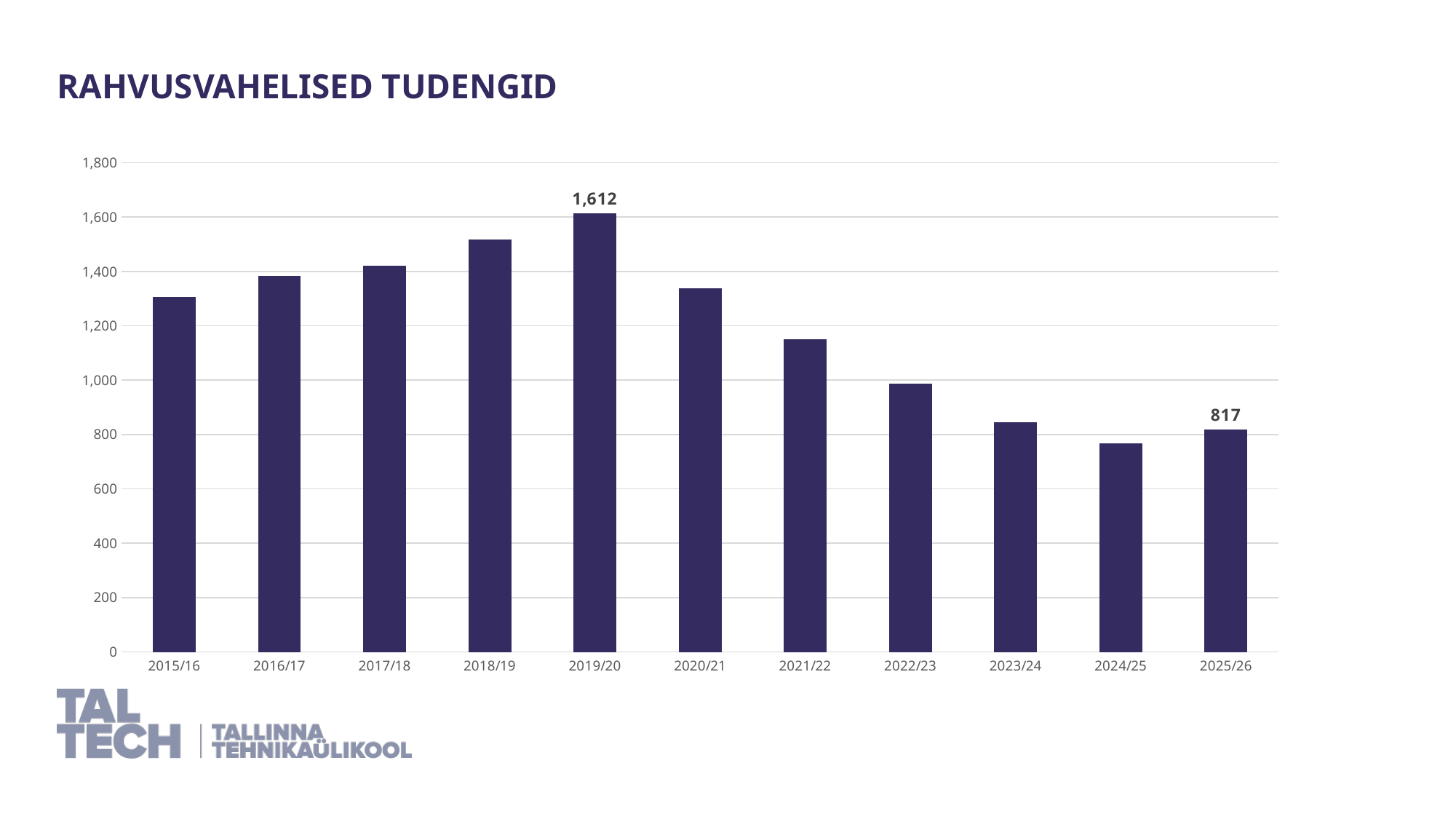
Is the value for 2023/24 greater or less than 1,000? less Which is larger, the value for 2015/16 or the value for 2020/21? 2020/21 How many academic years are shown on the x axis? 11 Is the value for 2021/22 greater or less than 1,000? greater What is the difference between the values for 2019/20 and 2025/26? 795 Is the value for 2018/19 greater or less than 1,400? greater What is the value for 2019/20? 1,612 What kind of chart is shown on the slide? Bar chart Which academic year has the lowest value? 2024/25 Which academic year has the highest value? 2019/20 What is the value for 2025/26? 817 What is the title of the slide? RAHVUSVAHELISED TUDENGID